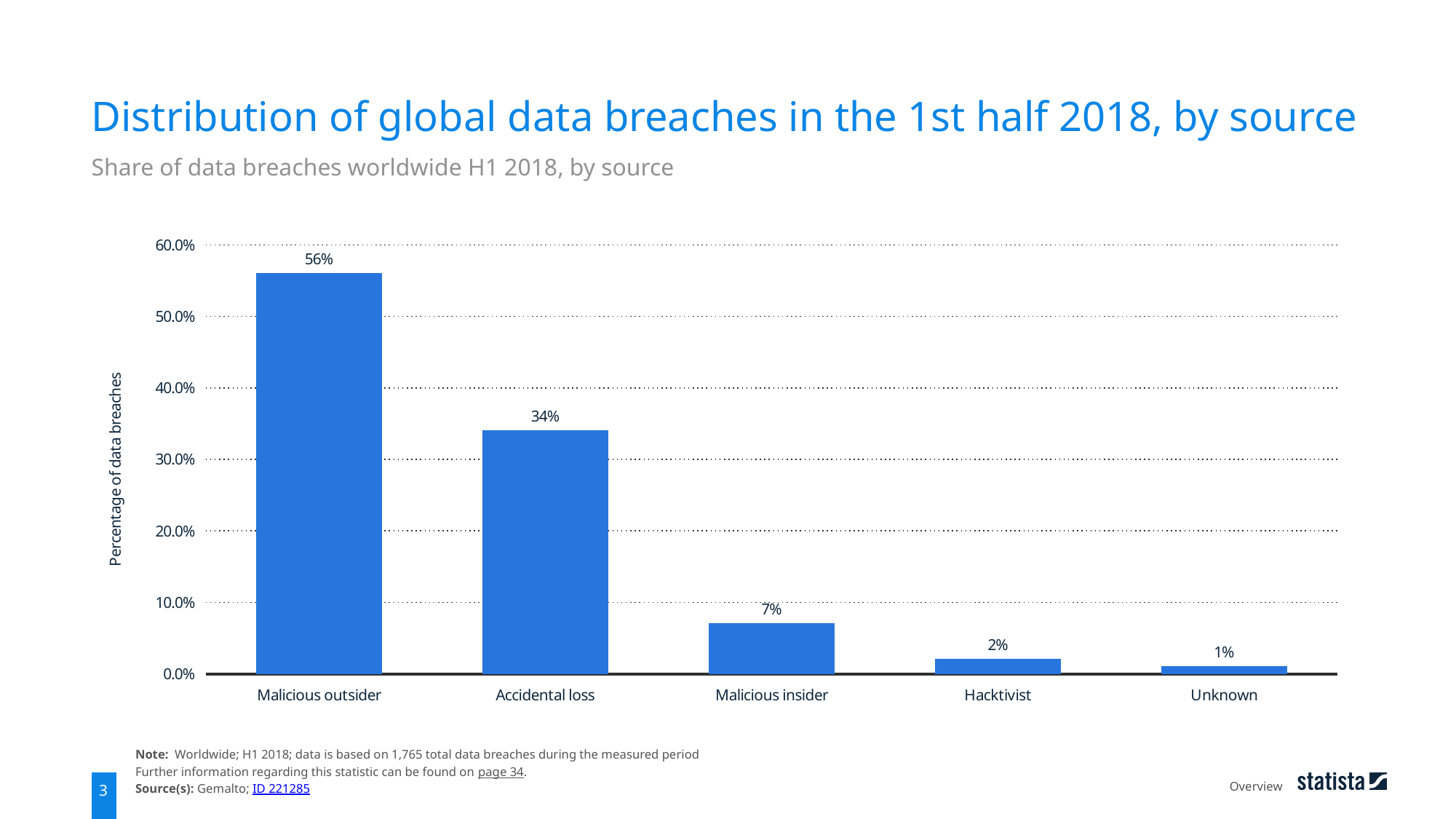
What is the value shown for Accidental loss? 34% What is the difference in percentage points between Malicious outsider and Accidental loss? 22 What is the value shown for Hacktivist? 2% How many source categories are shown on the x axis? 5 What percentage of data breaches is attributed to Malicious outsider? 56% Is the value for Accidental loss greater or less than 30.0%? greater What is the label of the vertical axis? Percentage of data breaches What kind of chart is shown on the slide? Bar chart Which is larger, the value for Malicious insider or the value for Hacktivist? Malicious insider Which source has the highest share of data breaches? Malicious outsider Which source has the lowest share of data breaches? Unknown What share of data breaches is attributed to Malicious insider? 7%